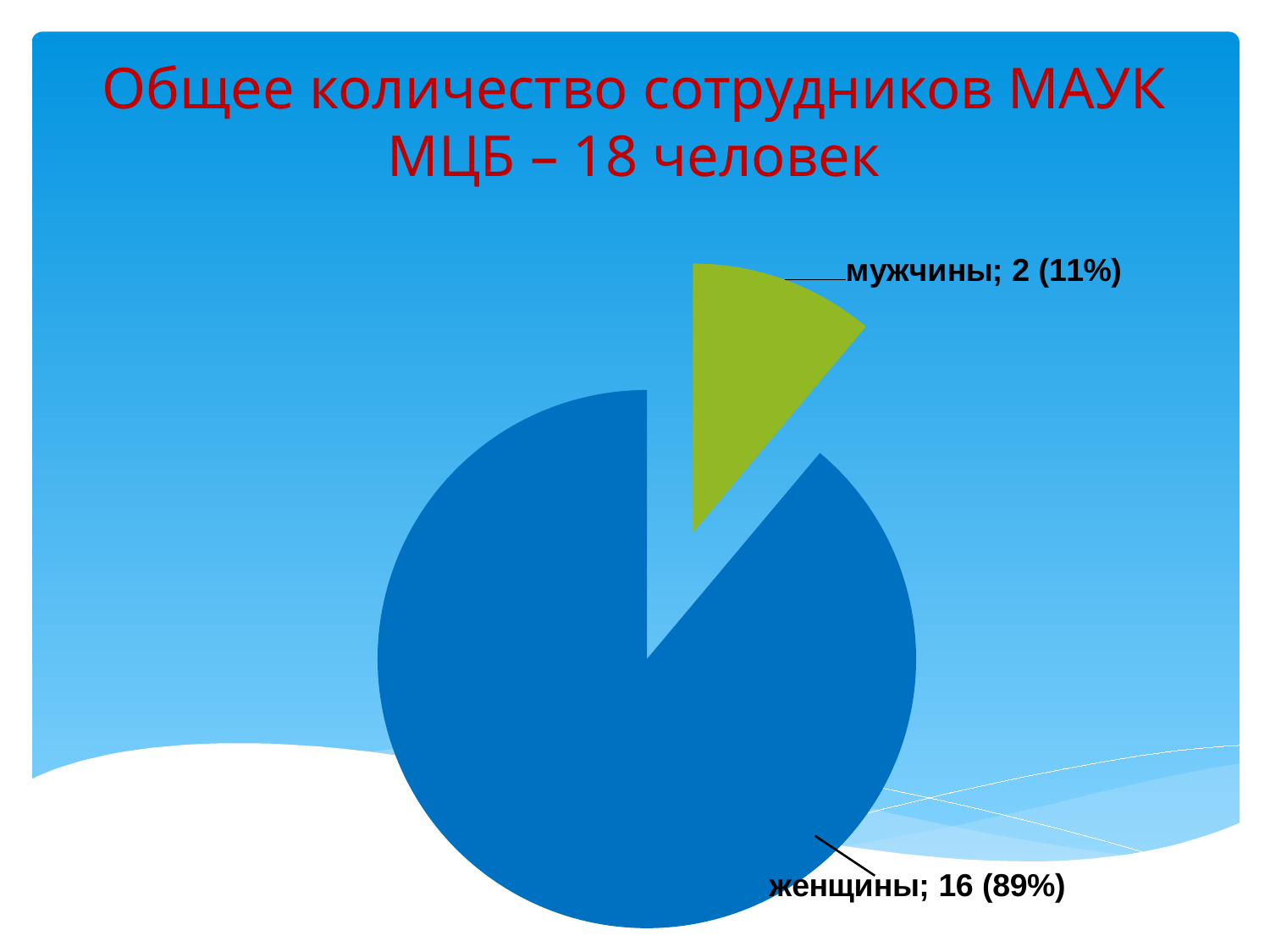
What kind of chart is shown on the slide? pie chart What share of the pie does the женщины slice represent? 89% Which slice is the largest? женщины How many employees are in the мужчины slice? 2 What is the total number of employees shown in the chart? 18 What share of the pie does the мужчины slice represent? 11% What is the difference between the number of женщины and мужчины? 14 How many employees are in the женщины slice? 16 What colour is the мужчины slice? green Which is larger, the женщины slice or the мужчины slice? женщины Which slice is the smallest? мужчины How many slices does the pie chart have? 2